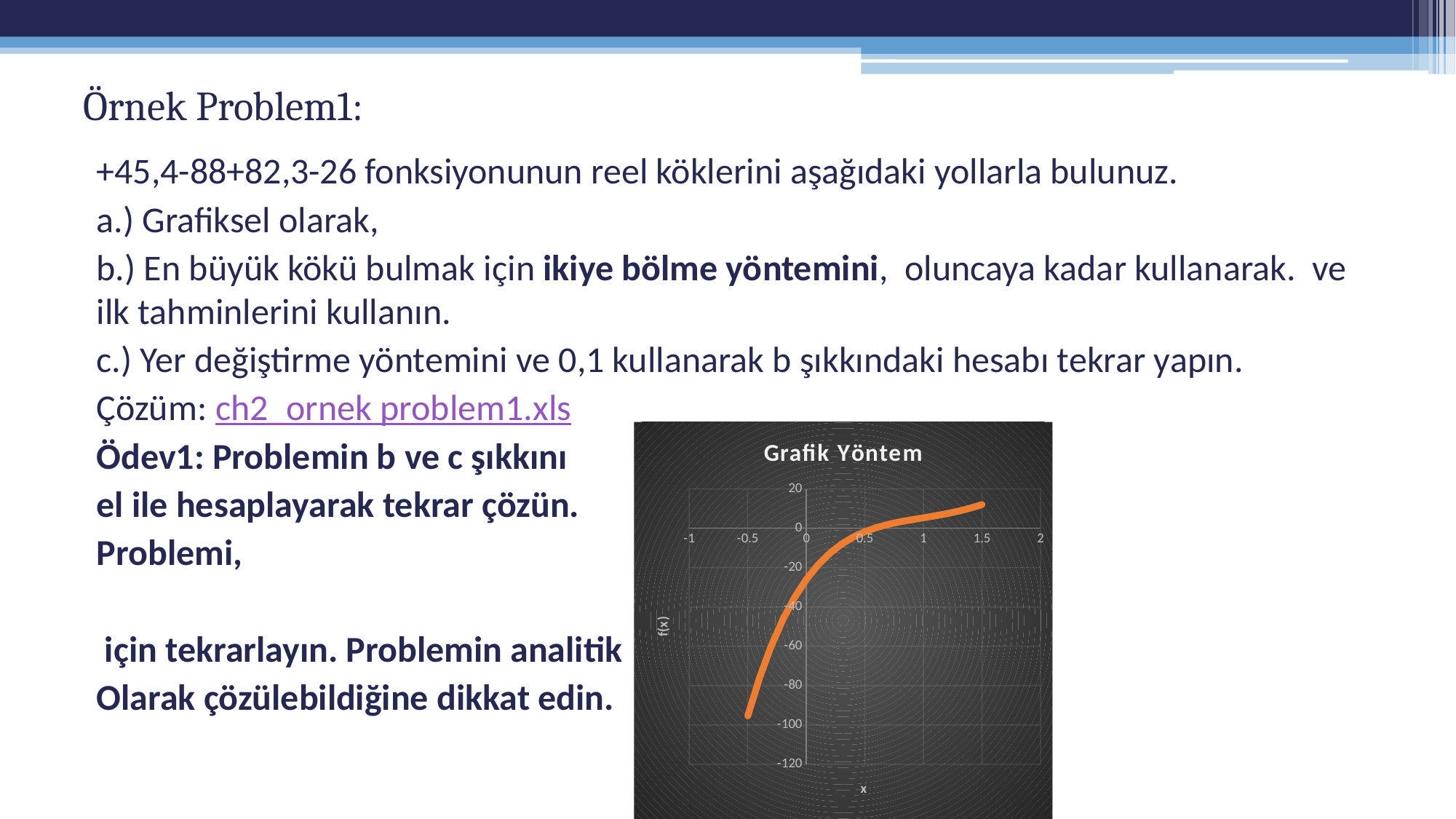
What is the title of the chart? Grafik Yöntem Which is larger, f(x) at x = 0.5 or f(x) at x = -0.5? f(x) at x = 0.5 Is the value of f(x) at x = 0 greater or less than -60? greater Is the value of f(x) at x = 1.5 greater or less than 0? greater Is the value of f(x) at x = 1 greater or less than -20? greater What is the lowest tick value shown on the vertical axis? -120 How many tick labels are shown on the horizontal axis? 7 Does the plotted line rise or fall as x increases? rises What is the label of the vertical axis of the chart? f(x) What kind of chart is shown on the slide? line chart